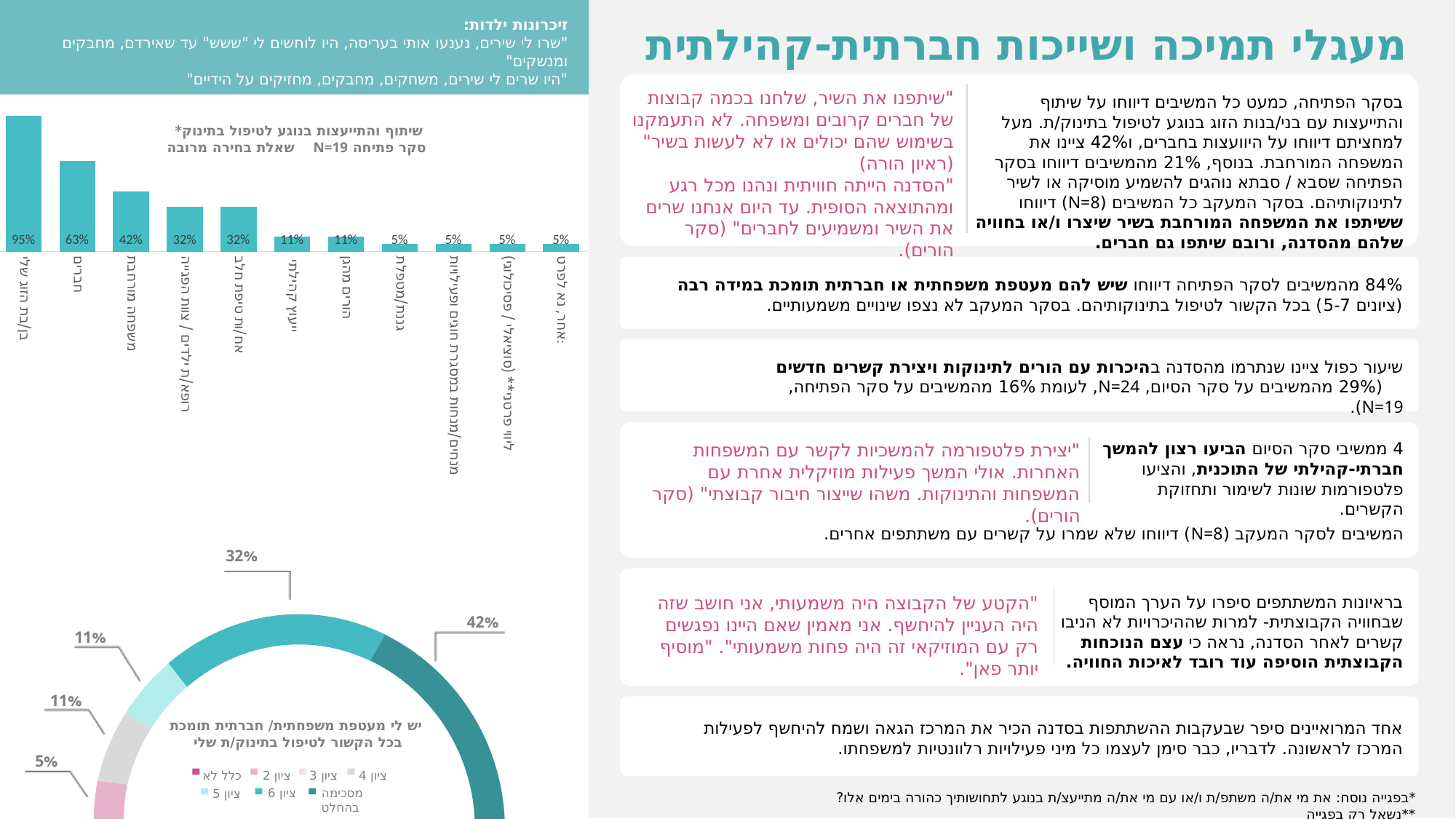
What sample size (N) is stated in the title of the bar chart 'שיתוף והתייעצות בנוגע לטיפול בתינוק'? N=19 In the bar chart 'שיתוף והתייעצות בנוגע לטיפול בתינוק', which is larger: ייעוץ קהילתי or גננת/מטפלת? ייעוץ קהילתי In the bar chart 'שיתוף והתייעצות בנוגע לטיפול בתינוק', what is the value for חברים? 63% In the bar chart 'שיתוף והתייעצות בנוגע לטיפול בתינוק', what is the difference between the values for חברים and משפחה מורחבת? 21 percentage points In the bar chart 'שיתוף והתייעצות בנוגע לטיפול בתינוק', what is the value for משפחה מורחבת? 42% In the semi-doughnut chart at the bottom left, what is the value of the largest slice? 42% What kind of chart is the chart titled 'שיתוף והתייעצות בנוגע לטיפול בתינוק'? Bar chart What kind of chart is the chart at the bottom left of the slide? Doughnut chart In the bar chart 'שיתוף והתייעצות בנוגע לטיפול בתינוק', which category has the highest value? בן/בת הזוג שלי In the semi-doughnut chart at the bottom left, what is the value for ציון 6? 32% How many bars are shown in the bar chart 'שיתוף והתייעצות בנוגע לטיפול בתינוק'? 11 How many entries does the legend of the semi-doughnut chart at the bottom left list? 7